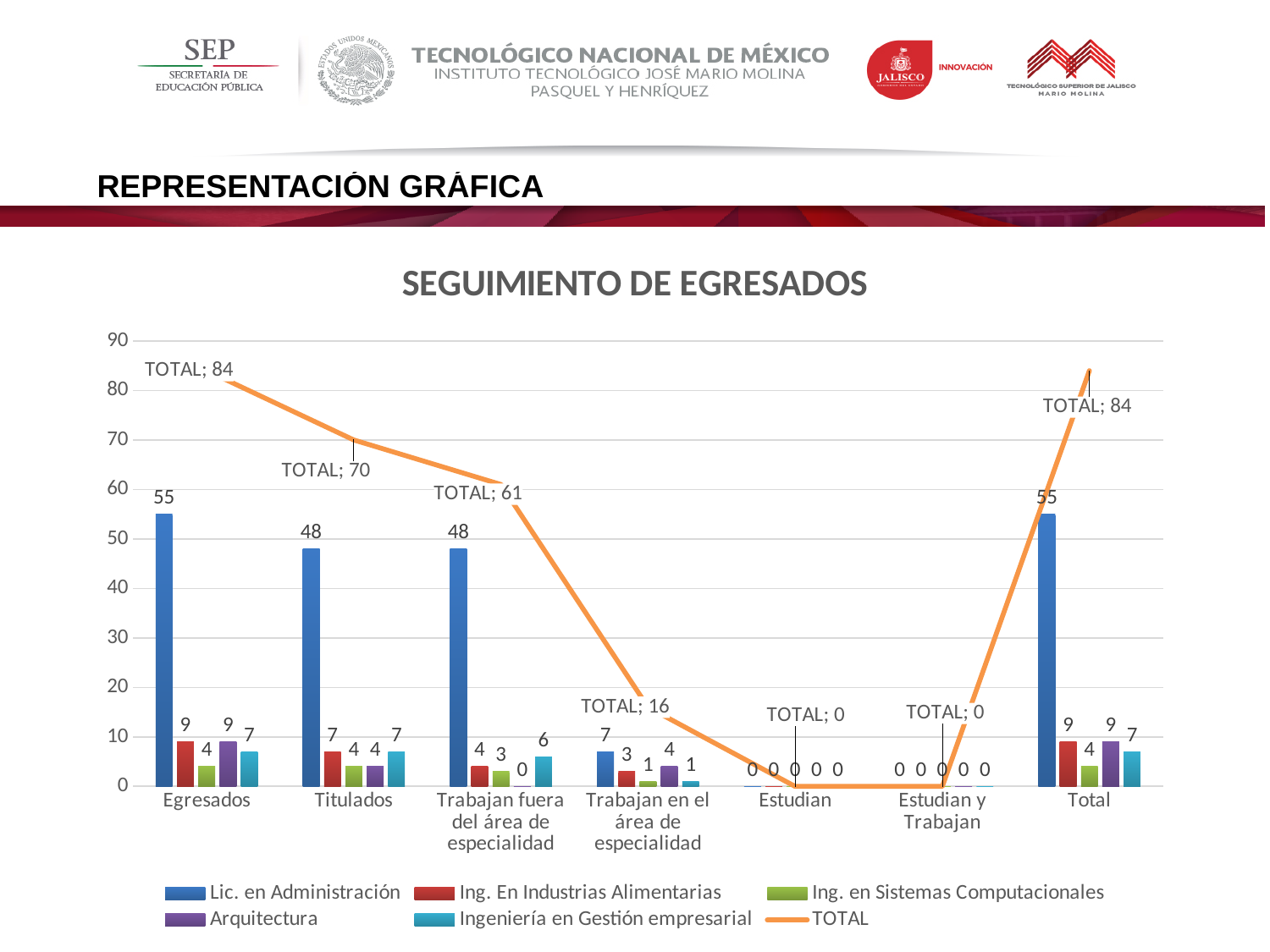
How many series does the legend list? 6 What is the difference between the TOTAL values for Egresados and Titulados? 14 What is the value for Lic. en Administración in the Egresados category? 55 What kind of chart is this? Combination bar and line chart Which category has the lowest value for Lic. en Administración among Egresados, Titulados, Trabajan fuera del área de especialidad and Trabajan en el área de especialidad? Trabajan en el área de especialidad What is the value of the TOTAL line for Titulados? 70 What is the value for Ingeniería en Gestión empresarial in the Trabajan fuera del área de especialidad category? 6 What is the value of the TOTAL line for Trabajan en el área de especialidad? 16 How many categories are shown on the x axis? 7 What is the title of the chart? SEGUIMIENTO DE EGRESADOS Is the TOTAL value for Trabajan fuera del área de especialidad greater or less than 60? greater Which is larger: the Arquitectura value for Egresados or the Arquitectura value for Titulados? Egresados